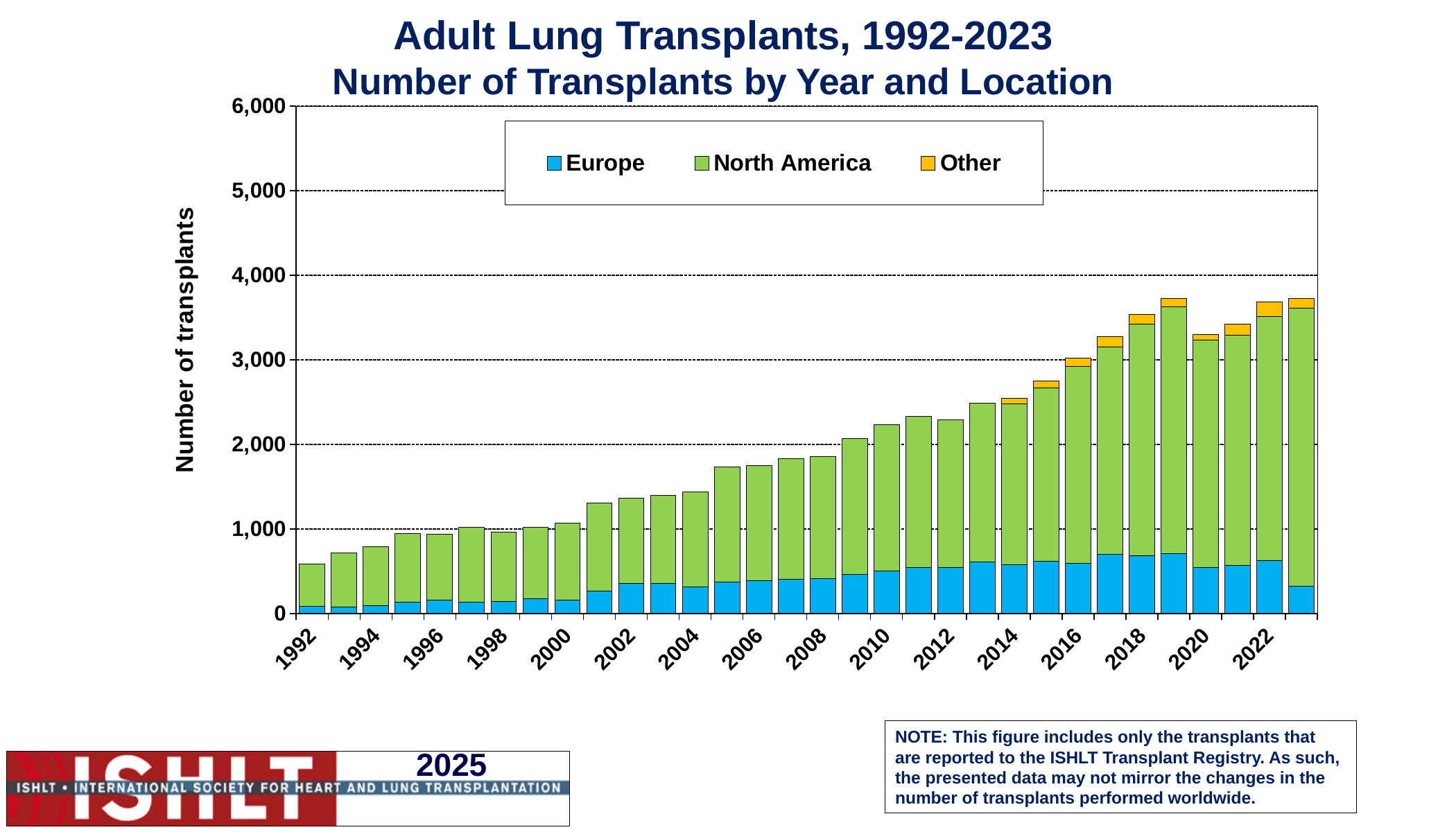
Is the total number of transplants in 2019 greater or less than 3,000? greater Is the total number of transplants in 2010 greater or less than 2,000? greater Is the total number of transplants in 1992 greater or less than 1,000? less Which year has the lowest total number of transplants? 1992 Which series are listed in the legend? Europe, North America, Other Overall, do the total number of transplants rise or fall from 1992 to 2023? rise How many series does the legend list? 3 What kind of chart is shown on the slide? Stacked bar chart Which year has a larger total number of transplants, 2019 or 2020? 2019 How many years (bars) are plotted in the chart? 32 What is the title of the chart? Adult Lung Transplants, 1992-2023 Number of Transplants by Year and Location